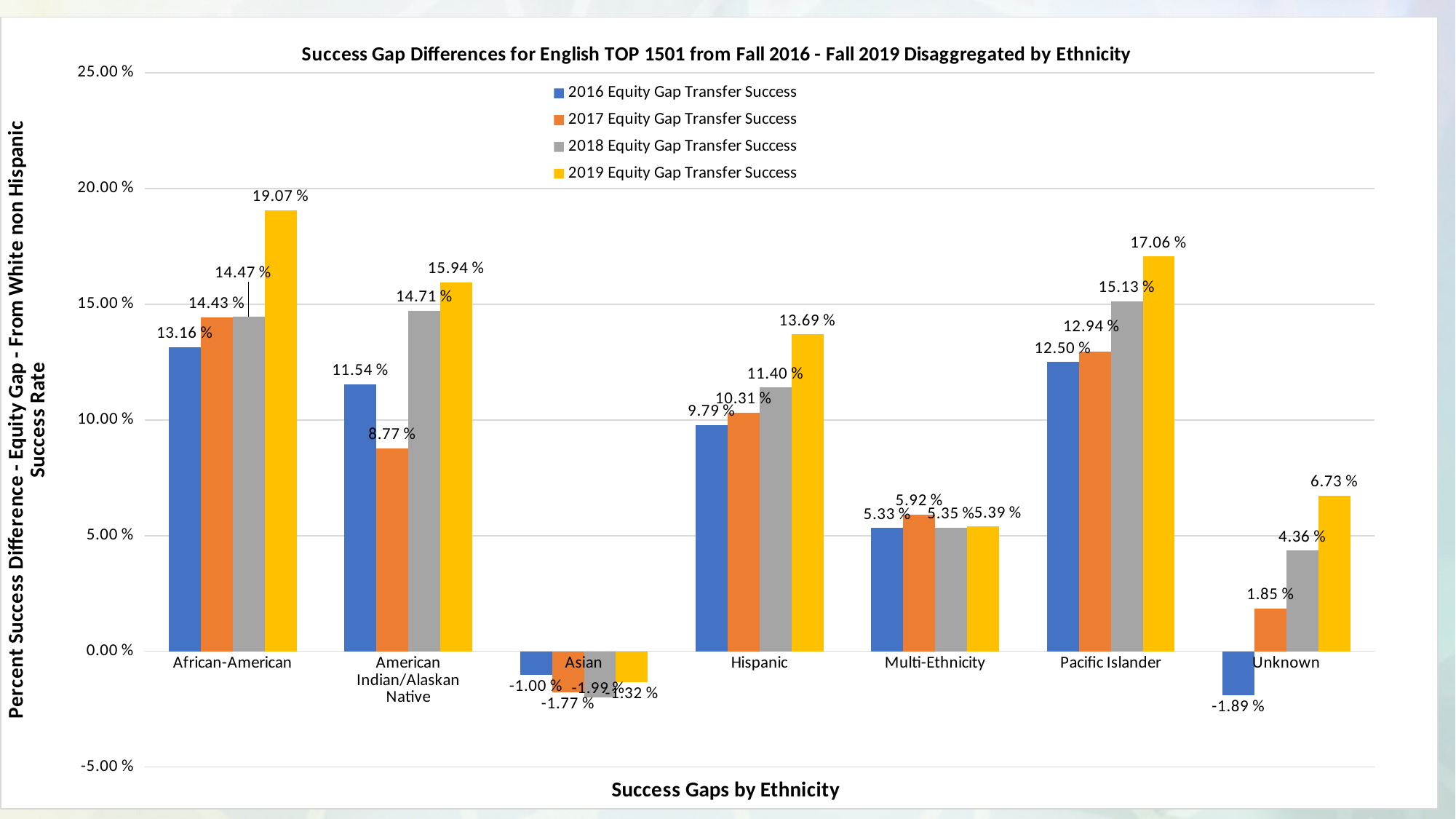
What is the 2016 Equity Gap Transfer Success value for Unknown? -1.89 % What is the difference between the 2019 and 2016 Equity Gap Transfer Success values for Pacific Islander? 4.56 % Which ethnicity has the lowest 2016 Equity Gap Transfer Success value? Unknown How many series does the legend list? 4 What is the 2017 Equity Gap Transfer Success value for American Indian/Alaskan Native? 8.77 % Is the 2019 Equity Gap Transfer Success value for Unknown greater or less than 5.00 %? greater Do the Equity Gap Transfer Success values for Unknown rise or fall from 2016 to 2019? rise How many ethnicity categories are shown on the x axis? 7 Which is larger, the 2018 Equity Gap Transfer Success value for Hispanic or for Multi-Ethnicity? Hispanic Which ethnicity has the highest 2019 Equity Gap Transfer Success value? African-American What kind of chart is shown on the slide? bar chart What is the 2019 Equity Gap Transfer Success value for African-American? 19.07 %